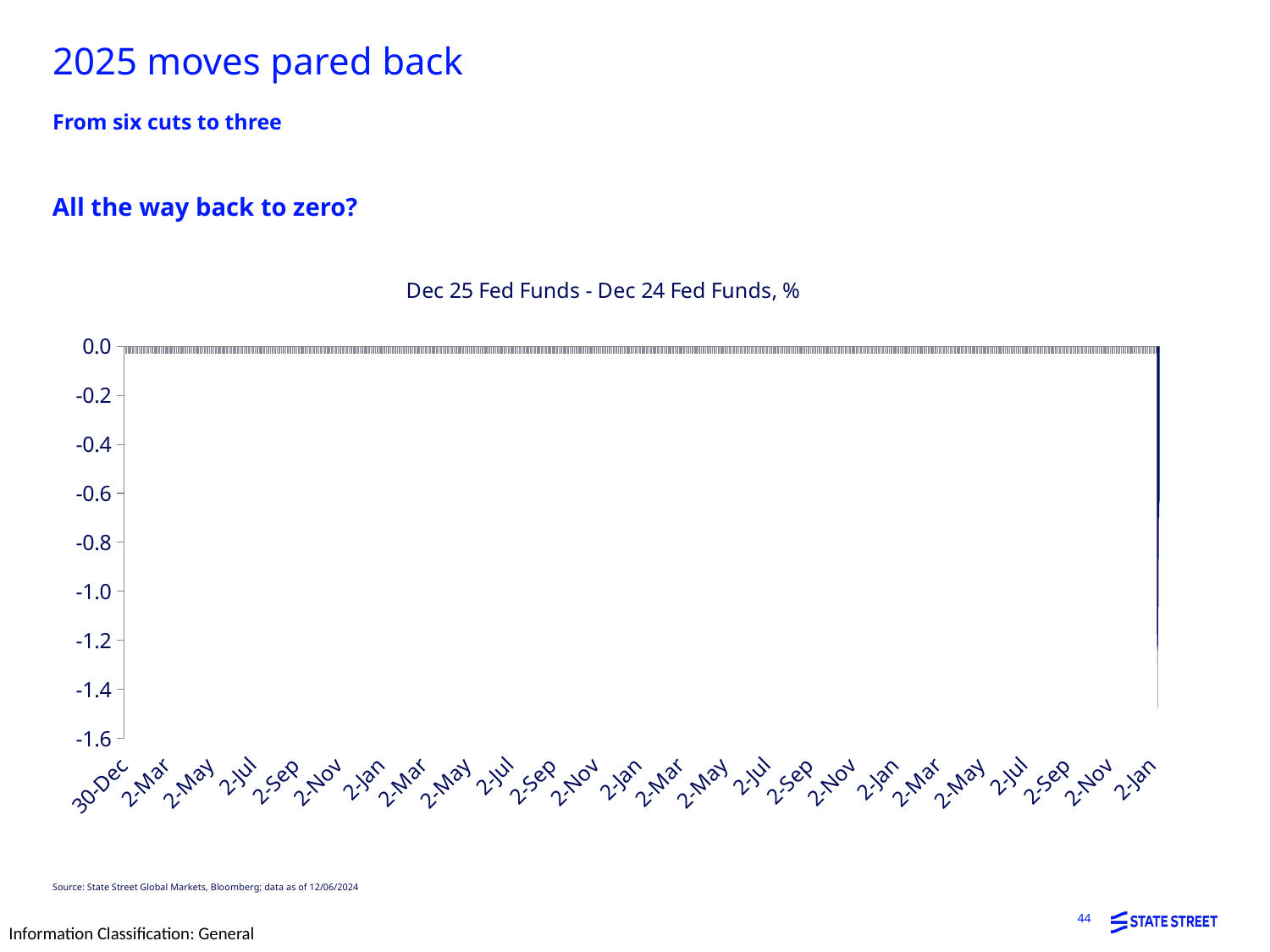
What is the last label on the chart's x axis? 2-Jan In what unit are the values on the chart expressed, according to the title? % What is the highest value shown on the chart's y axis? 0.0 What is the first label on the chart's x axis? 30-Dec What is the title of the chart? Dec 25 Fed Funds - Dec 24 Fed Funds, % What is the lowest value shown on the chart's y axis? -1.6